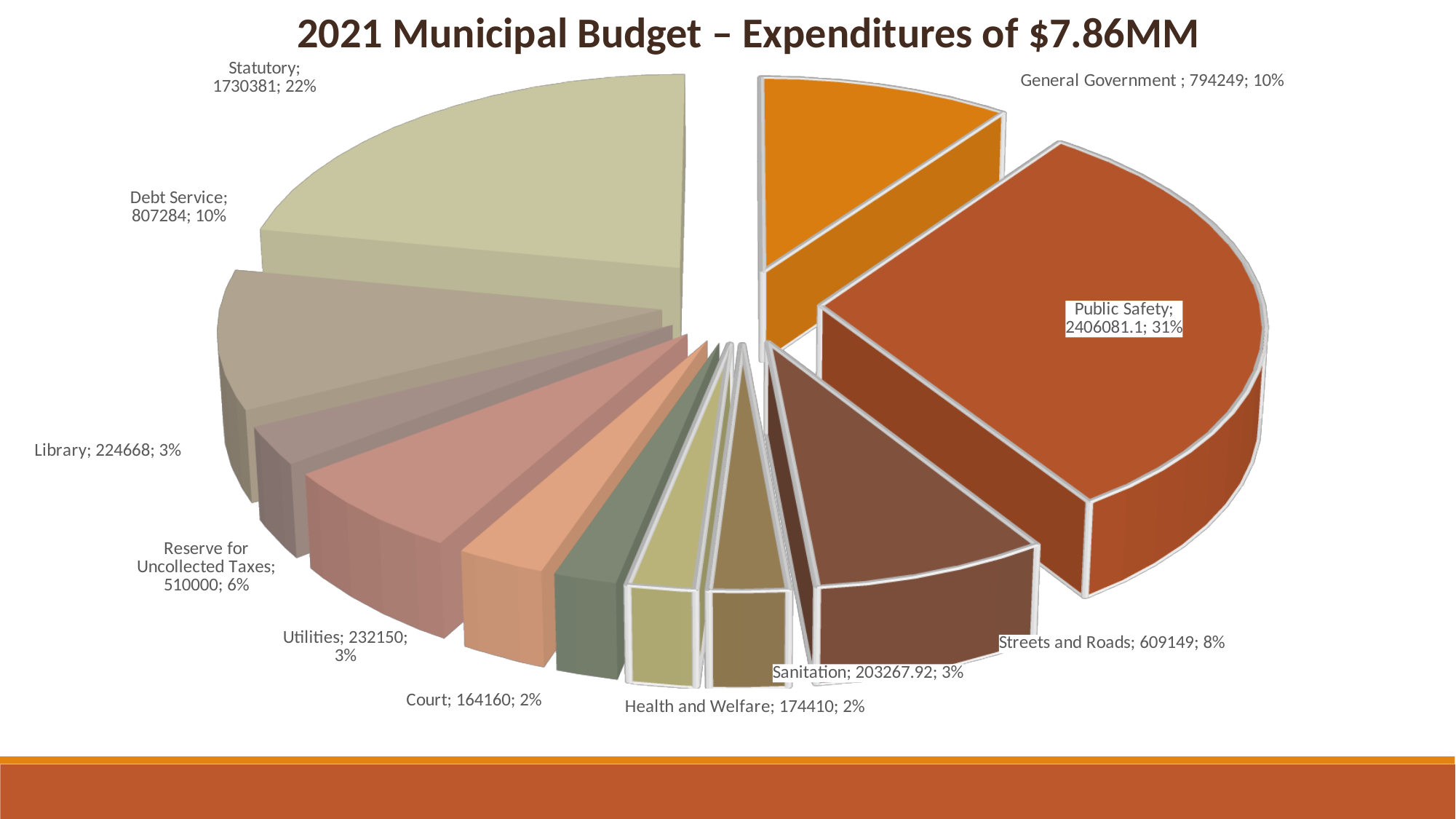
What is the difference between the values for Statutory and Debt Service? 923097 How many categories are shown in the pie chart? 11 Which is larger, the value for Debt Service or the value for General Government? Debt Service Which category has the largest slice of the pie? Public Safety What is the value for Reserve for Uncollected Taxes? 510000 What type of chart is shown on the slide? Pie chart What is the value for Sanitation? 203267.92 Which category has the smallest slice of the pie? Court What is the value for Statutory? 1730381 What is the value for Public Safety? 2406081.1 What is the difference between the values for Streets and Roads and Reserve for Uncollected Taxes? 99149 What share of the pie does Public Safety represent? 31%